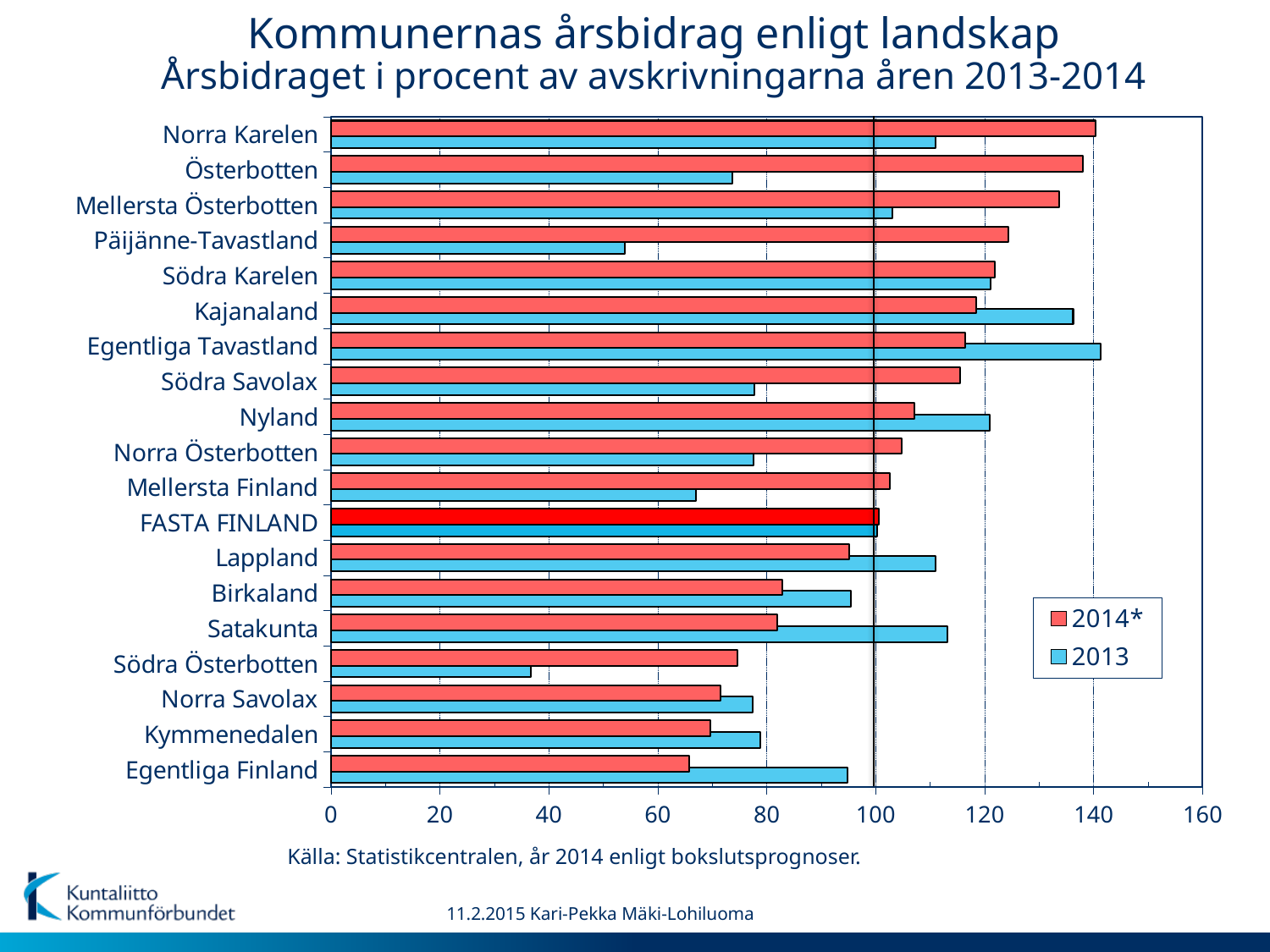
Which region has the highest 2013 value? Egentliga Tavastland Which region has the lowest 2013 value? Södra Österbotten Is the 2013 value for Satakunta greater or less than 100? greater Is the 2014* value for Österbotten greater or less than 120? greater Which region has the lowest 2014* value? Egentliga Finland For Kajanaland, which is larger: the 2013 value or the 2014* value? 2013 How many regions (categories) are plotted on the chart? 19 Is the 2013 value for Päijänne-Tavastland greater or less than 60? less Which region has the highest 2014* value? Norra Karelen How many series does the legend list? 2 What are the two entries listed in the legend? 2014* and 2013 What kind of chart is shown on the slide? bar chart